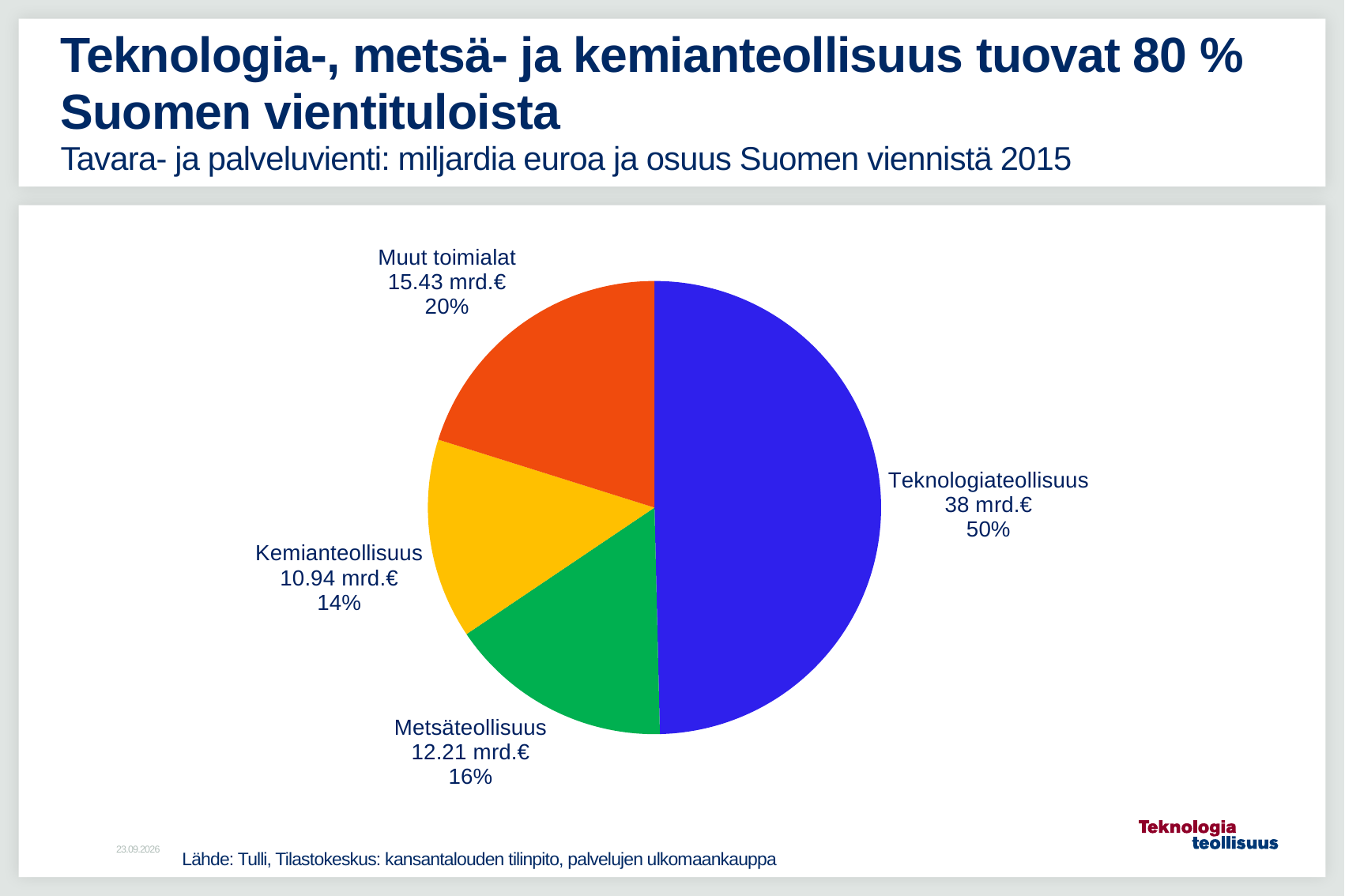
What share of the pie does Teknologiateollisuus represent? 50% Which sector has the largest slice of the pie? Teknologiateollisuus What is the export value shown for Metsäteollisuus? 12.21 mrd.€ Which sector has the smallest slice of the pie? Kemianteollisuus What is the export value shown for Kemianteollisuus? 10.94 mrd.€ Which has a larger export value, Metsäteollisuus or Kemianteollisuus? Metsäteollisuus What share of the pie does Kemianteollisuus represent? 14% What is the export value shown for Teknologiateollisuus? 38 mrd.€ What type of chart is shown on the slide? Pie chart What is the difference in export value between Teknologiateollisuus and Muut toimialat? 22.57 mrd.€ How many slices does the pie chart have? 4 What is the export value shown for Muut toimialat? 15.43 mrd.€